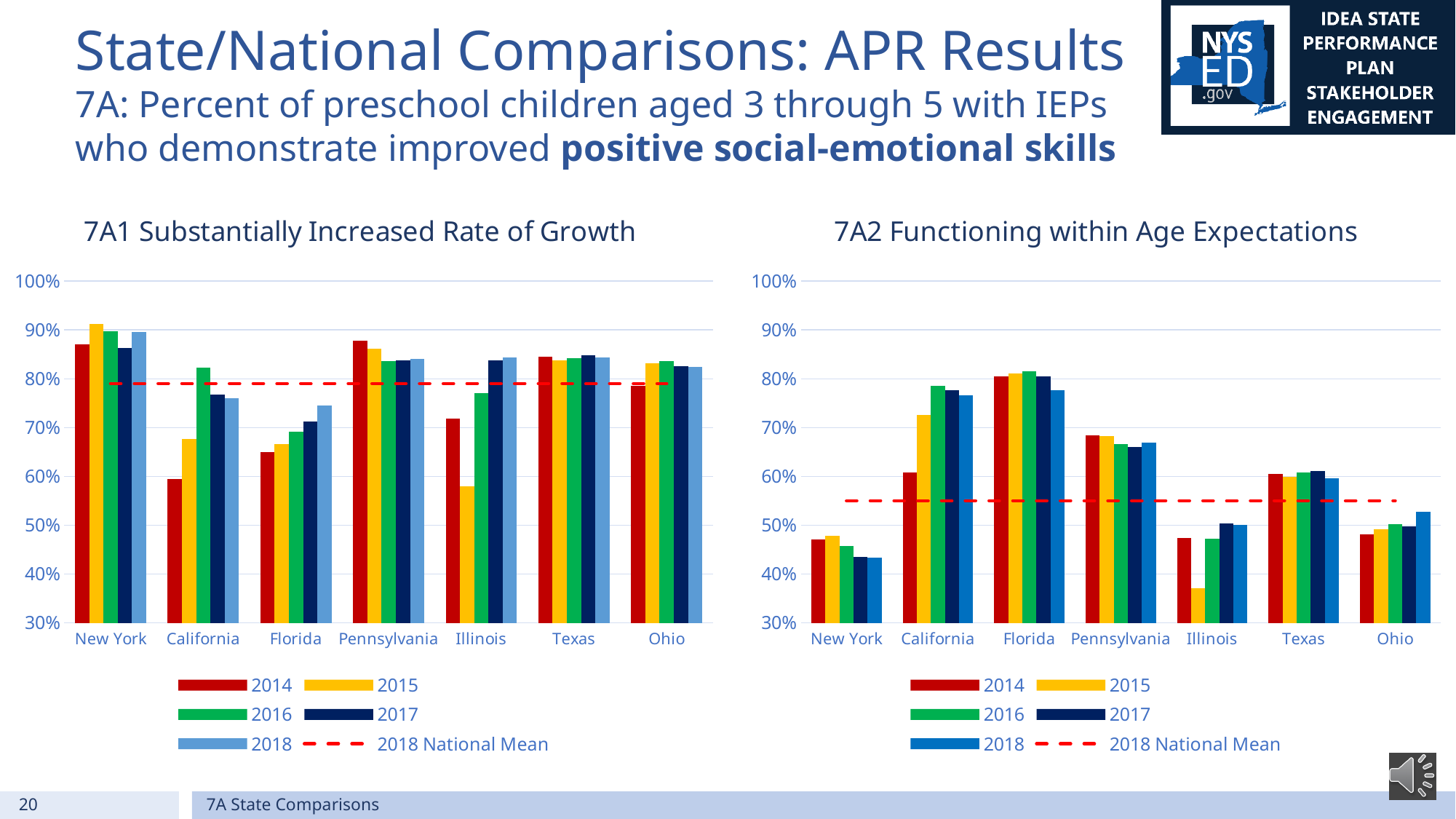
In the 7A1 Substantially Increased Rate of Growth chart, which state has the lowest 2014 value? California In the 7A1 Substantially Increased Rate of Growth chart, is the 2015 value for New York greater or less than 90%? greater How many entries does the legend of the 7A1 Substantially Increased Rate of Growth chart list? 6 How many states are shown on the x axis of the 7A2 Functioning within Age Expectations chart? 7 In the 7A2 Functioning within Age Expectations chart, is the 2015 value for Illinois greater or less than 40%? less In the 7A2 Functioning within Age Expectations chart, which state has the highest 2015 value? Florida In the 7A2 Functioning within Age Expectations chart, is the 2016 value for Florida greater or less than 80%? greater In the 7A2 Functioning within Age Expectations chart, which is larger, the 2018 value for California or the 2018 value for New York? California What kind of chart is the 7A1 Substantially Increased Rate of Growth chart? bar chart In the 7A1 Substantially Increased Rate of Growth chart, do Florida's values rise or fall from 2014 to 2018? rise In the 7A2 Functioning within Age Expectations chart, which state has the lowest 2015 value? Illinois